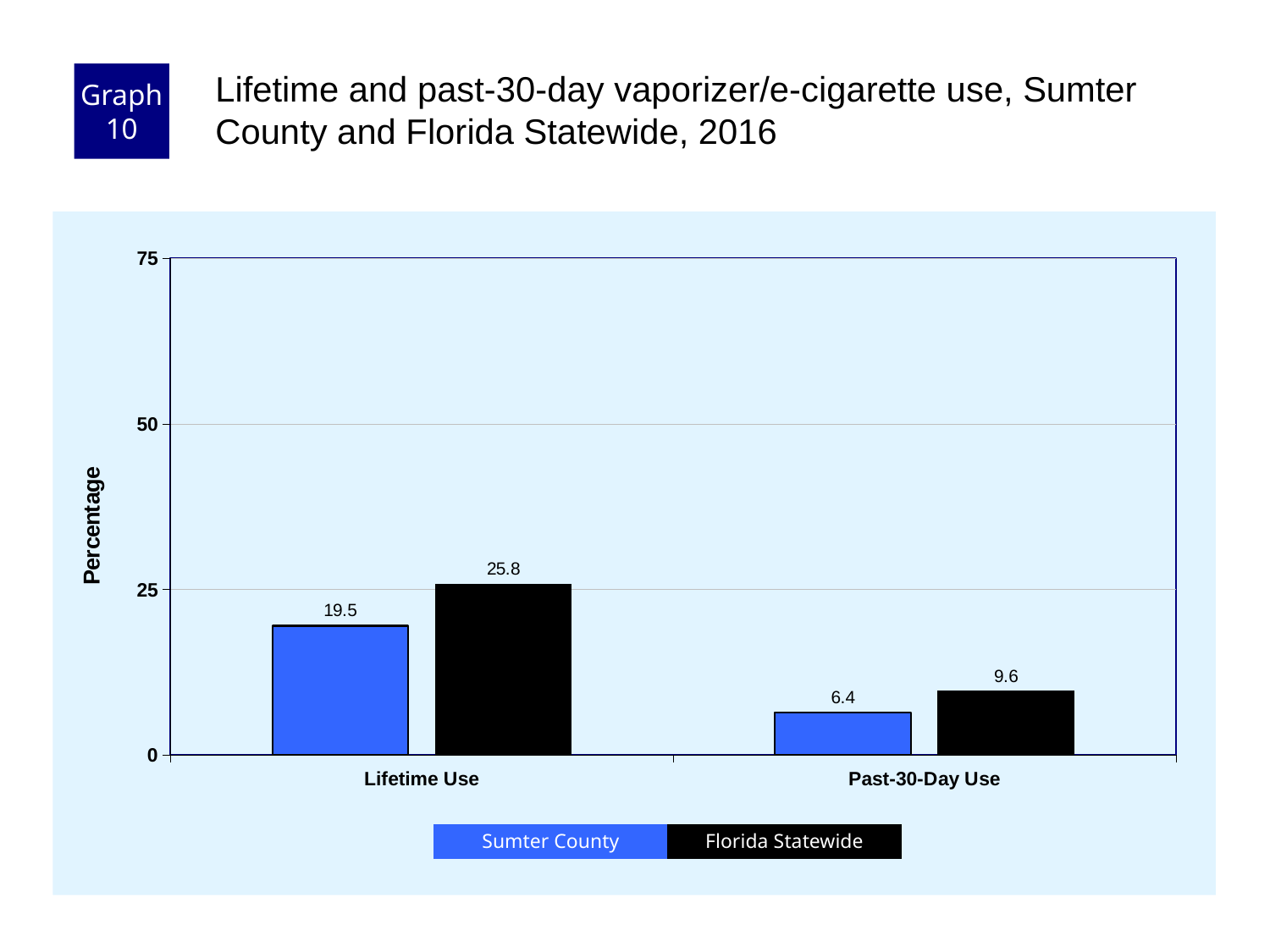
What kind of chart is shown on the slide? Bar chart Which bar has the highest value on the chart? Florida Statewide, Lifetime Use How many series does the legend list? 2 What is the Sumter County value for Past-30-Day Use? 6.4 What is the Florida Statewide value for Lifetime Use? 25.8 What is the difference between the Florida Statewide and Sumter County values for Lifetime Use? 6.3 What is the difference between the Florida Statewide and Sumter County values for Past-30-Day Use? 3.2 What is the Sumter County value for Lifetime Use? 19.5 Which bar has the lowest value on the chart? Sumter County, Past-30-Day Use Which is larger for Lifetime Use, Sumter County or Florida Statewide? Florida Statewide What is the Florida Statewide value for Past-30-Day Use? 9.6 What colour represents Sumter County in the chart? Blue